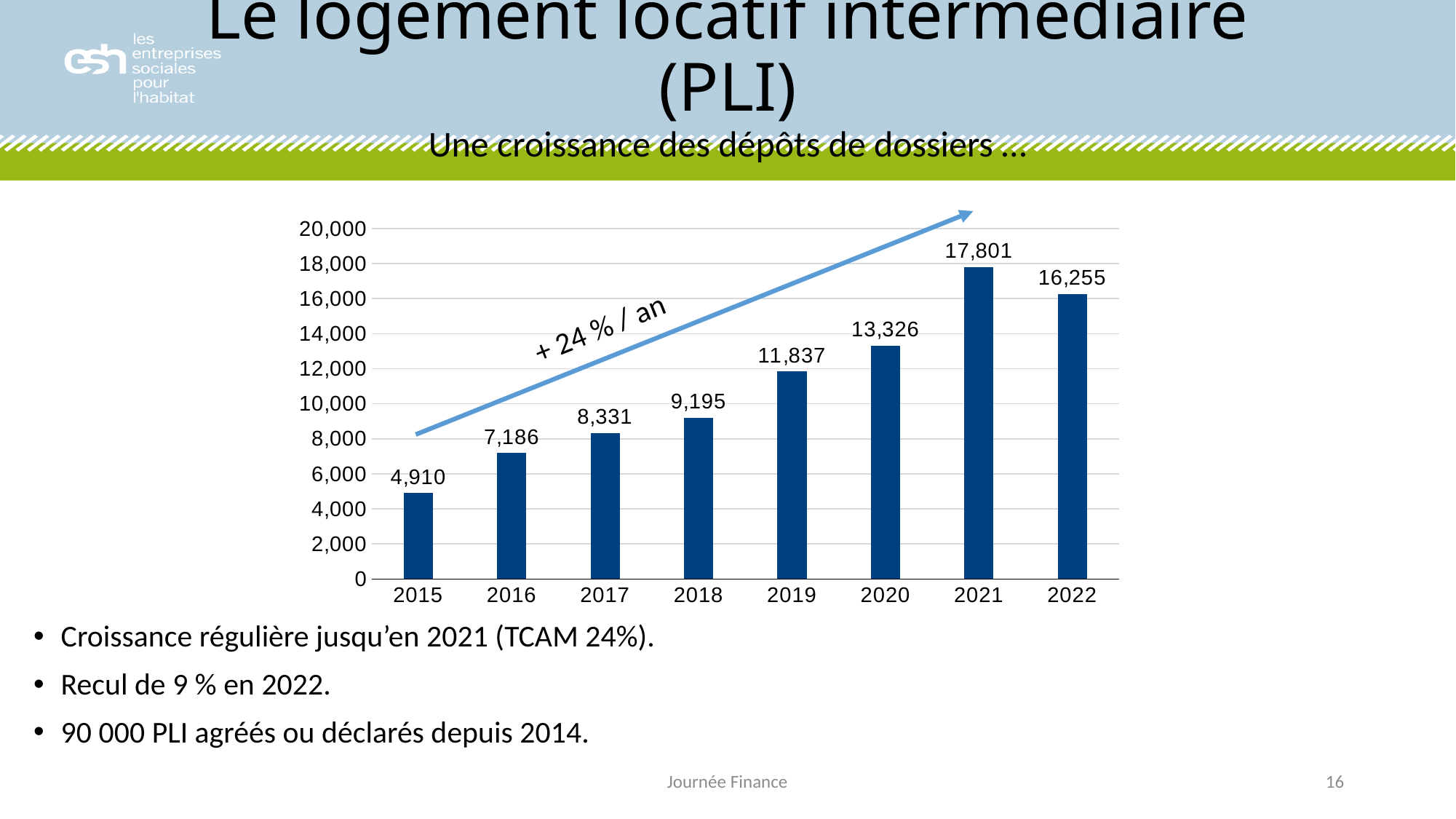
Which is larger, the value for 2018 or the value for 2020? 2020 What is the difference between the values for 2021 and 2022? 1,546 Is the value for 2017 greater or less than 10,000? less What is the value for 2019? 11,837 Which year has the lowest value? 2015 Which year has the highest value? 2021 What is the value for 2015? 4,910 What is the value for 2022? 16,255 How many years are shown on the x axis? 8 What is the difference between the values for 2016 and 2015? 2,276 What kind of chart is shown on the slide? bar chart What annual growth rate is written along the arrow on the chart? + 24 % / an